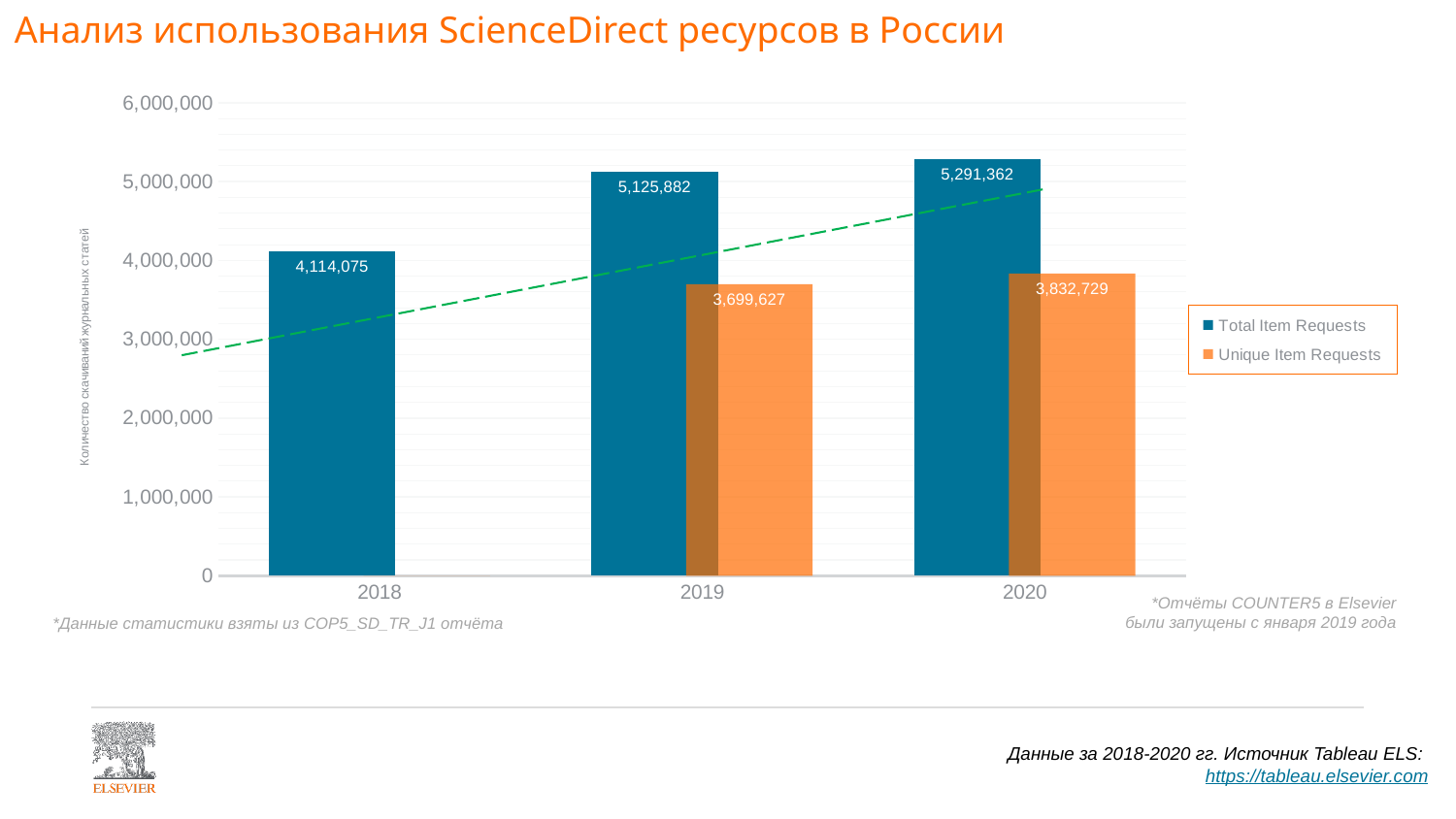
What is the value of Unique Item Requests for 2020? 3,832,729 What is the difference between Total Item Requests in 2019 and 2018? 1,011,807 Which is larger: Unique Item Requests in 2019 or Unique Item Requests in 2020? Unique Item Requests in 2020 In which year is Total Item Requests lowest? 2018 What kind of chart is shown on the slide? Bar chart What is the difference between Total Item Requests and Unique Item Requests in 2020? 1,458,633 In which year is Total Item Requests highest? 2020 Do the Total Item Requests values rise or fall from 2018 to 2020? Rise What is the value of Unique Item Requests for 2019? 3,699,627 What is the value of Total Item Requests for 2020? 5,291,362 How many series does the legend list? 2 What is the value of Total Item Requests for 2018? 4,114,075